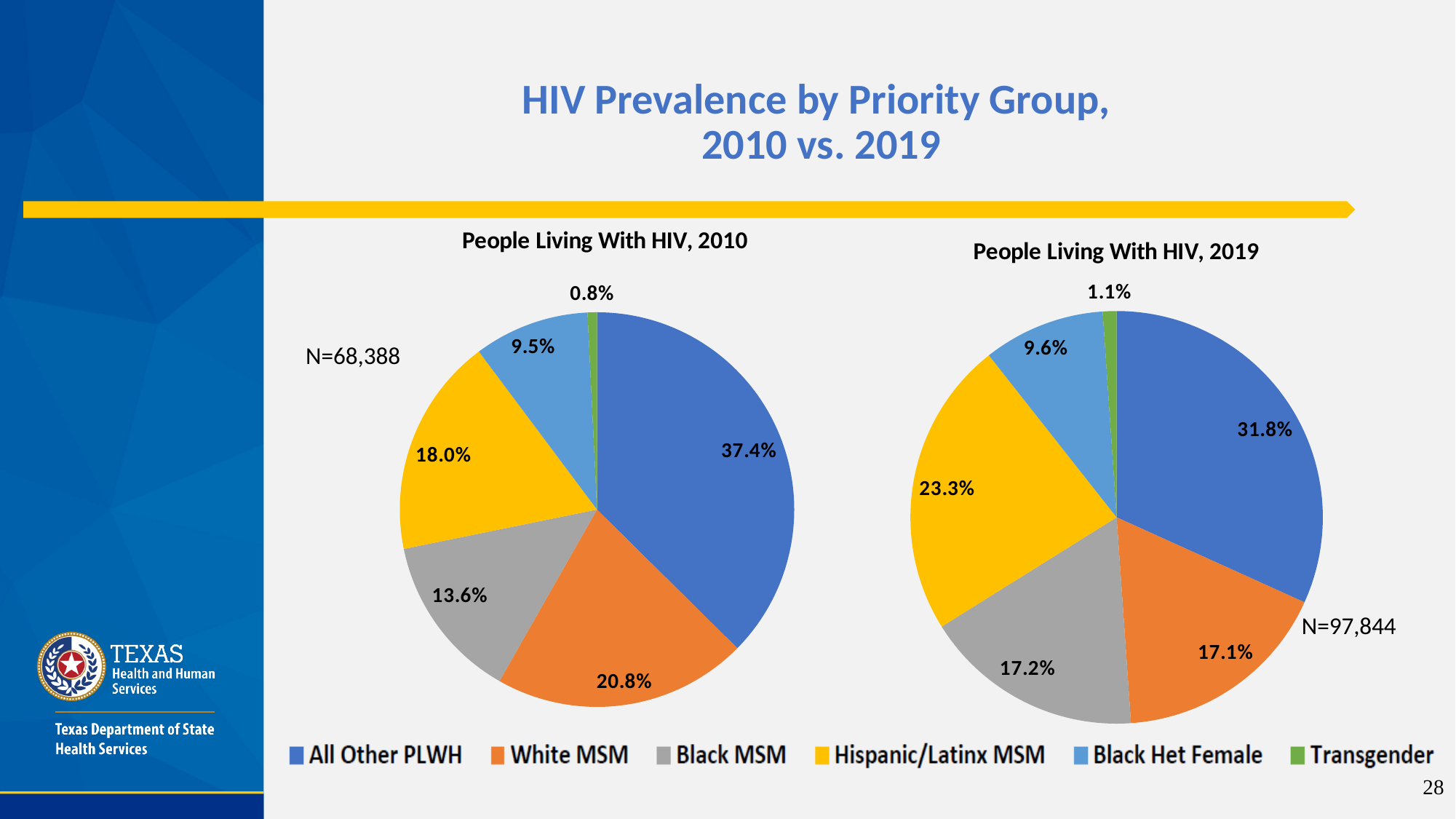
In the 'People Living With HIV, 2019' chart, what share is labelled for the Hispanic/Latinx MSM slice? 23.3% How many groups does the shared legend list? 6 In the 'People Living With HIV, 2010' chart, what share is labelled for the All Other PLWH slice? 37.4% In the 'People Living With HIV, 2019' chart, what share is labelled for the Transgender slice? 1.1% What is the N value shown next to the 'People Living With HIV, 2019' chart? N=97,844 What type of chart is 'People Living With HIV, 2010'? Pie chart In the 'People Living With HIV, 2010' chart, what share is labelled for the Black MSM slice? 13.6% In the 'People Living With HIV, 2010' chart, which group has the smallest slice? Transgender In the 'People Living With HIV, 2019' chart, which group has the largest slice? All Other PLWH In the 'People Living With HIV, 2019' chart, which is larger: the Hispanic/Latinx MSM slice or the White MSM slice? Hispanic/Latinx MSM How many slices does the 'People Living With HIV, 2019' chart have? 6 In the 'People Living With HIV, 2010' chart, what is the difference between the White MSM share and the Black MSM share? 7.2%